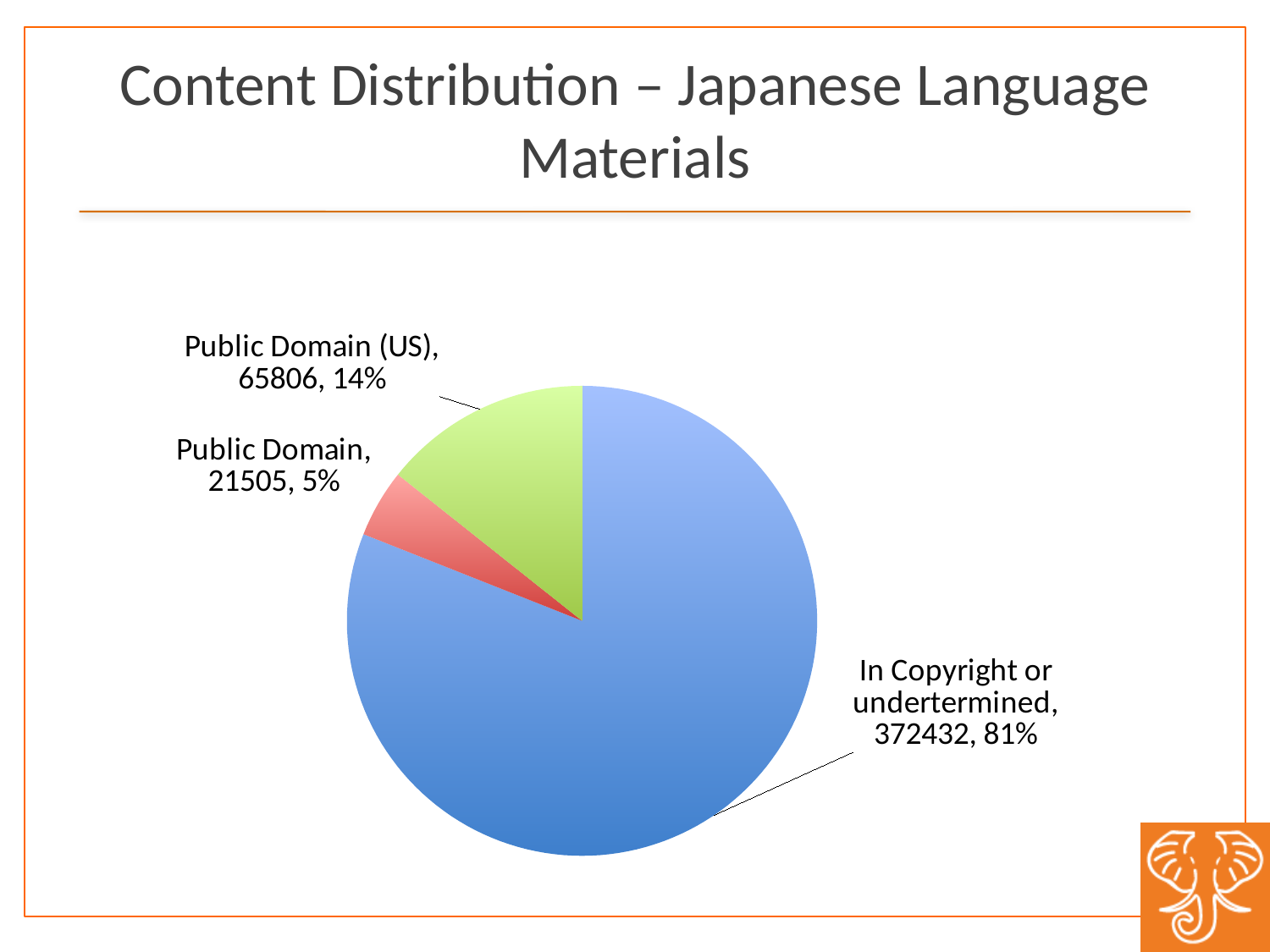
Which category has the smallest slice? Public Domain What kind of chart is shown on the slide? pie chart How many slices does the pie chart have? 3 What is the title of the chart? Content Distribution – Japanese Language Materials Which category has the largest slice? In Copyright or undertermined What is the difference between the values for Public Domain (US) and Public Domain? 44301 What share of the pie does In Copyright or undertermined represent? 81% What share of the pie does Public Domain (US) represent? 14% Which is larger, Public Domain (US) or Public Domain? Public Domain (US) What is the value for Public Domain? 21505 What is the value for Public Domain (US)? 65806 What is the value for In Copyright or undertermined? 372432